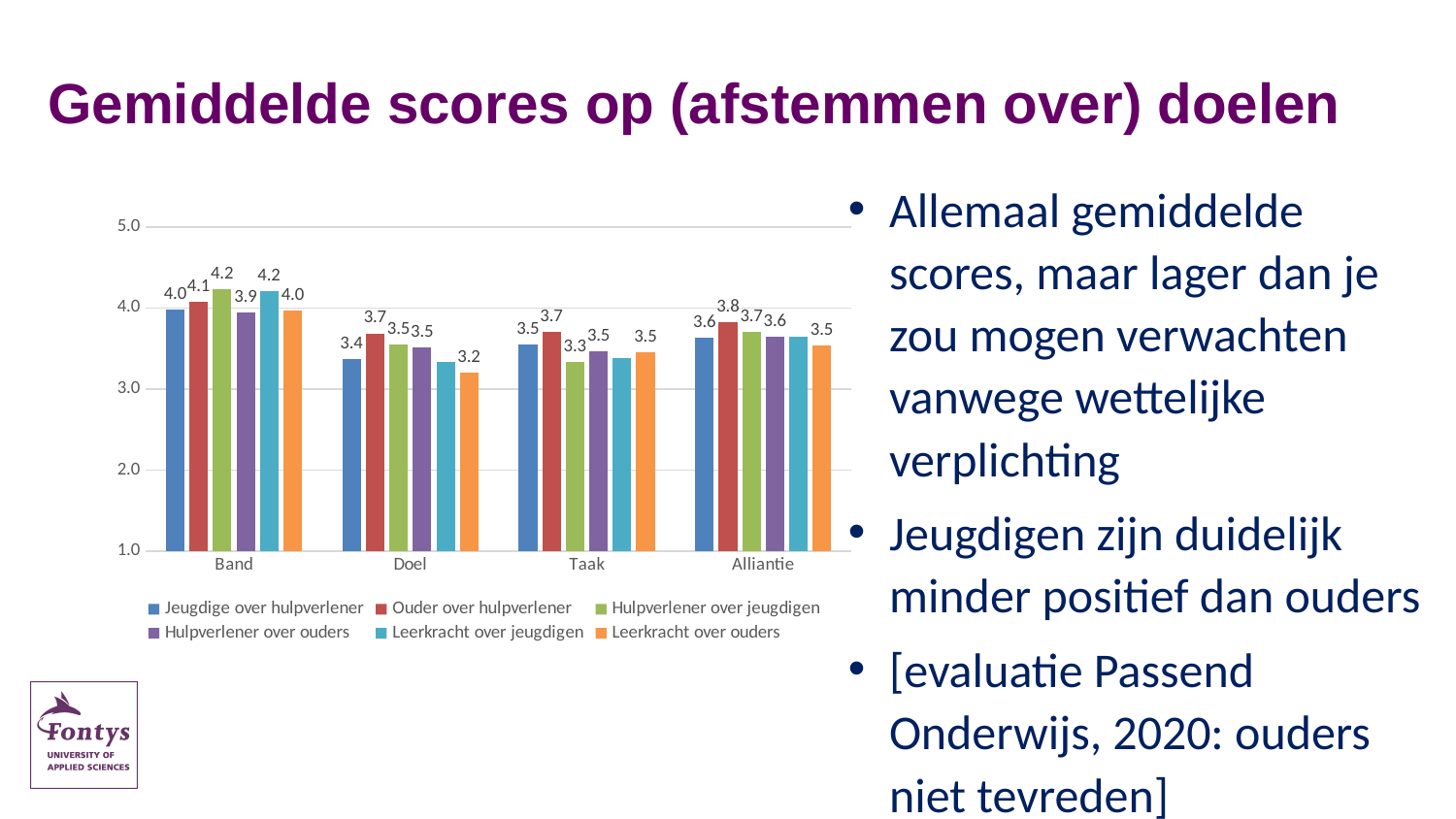
Is the value for 'Leerkracht over jeugdigen' in the Band category greater or less than 4.0? greater Which is larger: the 'Hulpverlener over ouders' value for Band or for Taak? Band What is the value for 'Leerkracht over ouders' in the Doel category? 3.2 What is the difference between the 'Ouder over hulpverlener' value and the 'Jeugdige over hulpverlener' value in the Doel category? 0.3 Which series has the lowest value in the Doel category? Leerkracht over ouders What is the value for 'Ouder over hulpverlener' in the Band category? 4.1 How many series does the legend list? 6 What is the value for 'Hulpverlener over jeugdigen' in the Taak category? 3.3 What is the value for 'Jeugdige over hulpverlener' in the Alliantie category? 3.6 Which series has the highest value in the Alliantie category? Ouder over hulpverlener What kind of chart is shown on the slide? Bar chart How many categories are shown on the x axis? 4